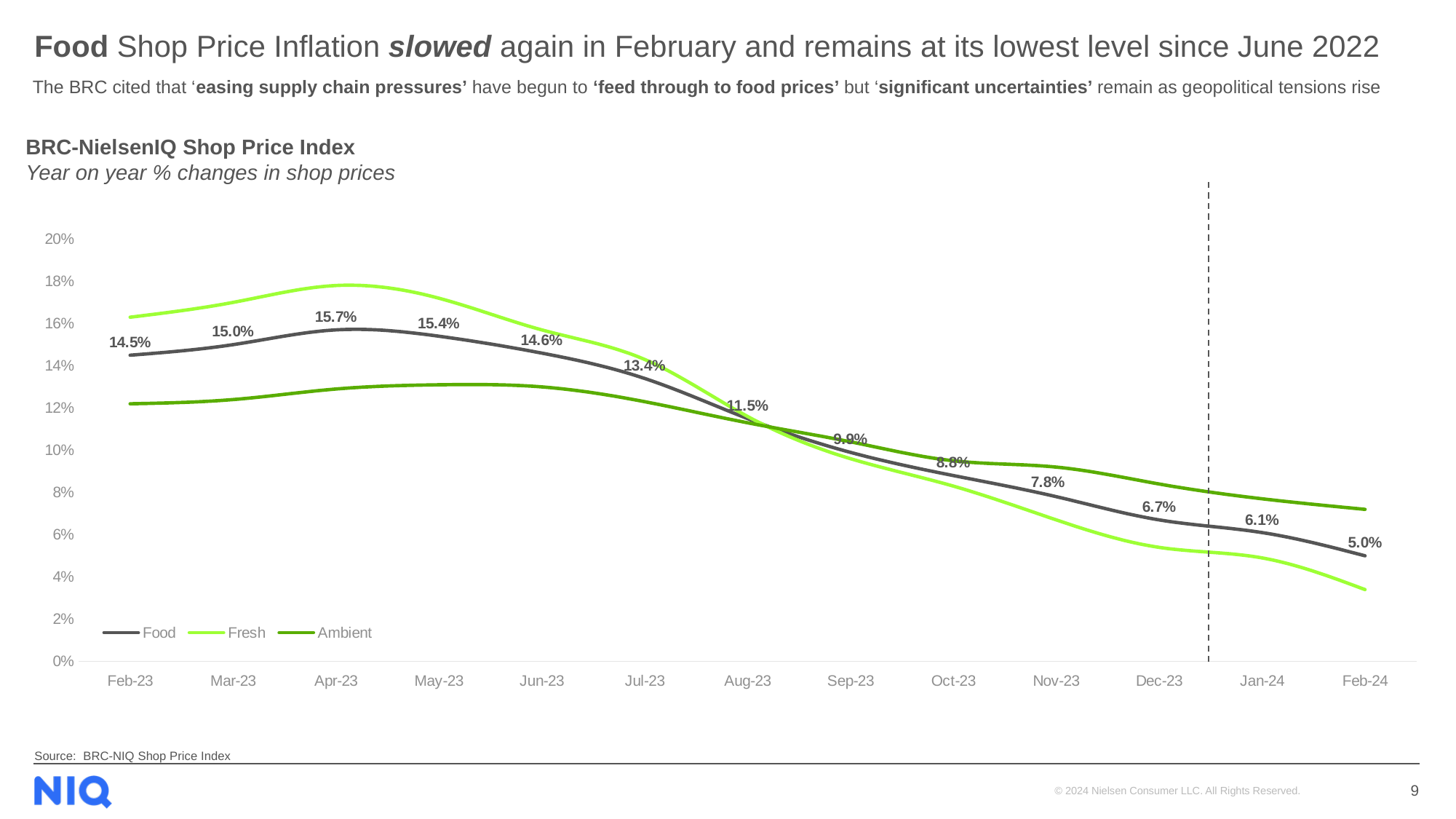
What is the difference between the Food value in Feb-23 and the Food value in Feb-24? 9.5 percentage points What is the Food value for Apr-23? 15.7% What is the Food value for Feb-24? 5.0% In which month does the Food series reach its highest value? Apr-23 Is the Fresh value for Feb-24 greater or less than 4%? less In which month does the Food series reach its lowest value? Feb-24 Is the Ambient value for Feb-24 greater or less than 6%? greater Which is larger, the Food value for Jul-23 or the Food value for Sep-23? Jul-23 How many series does the legend list? 3 What is the Food value for Aug-23? 11.5% How many months are plotted on the x axis? 13 What kind of chart is shown on the slide? Line chart